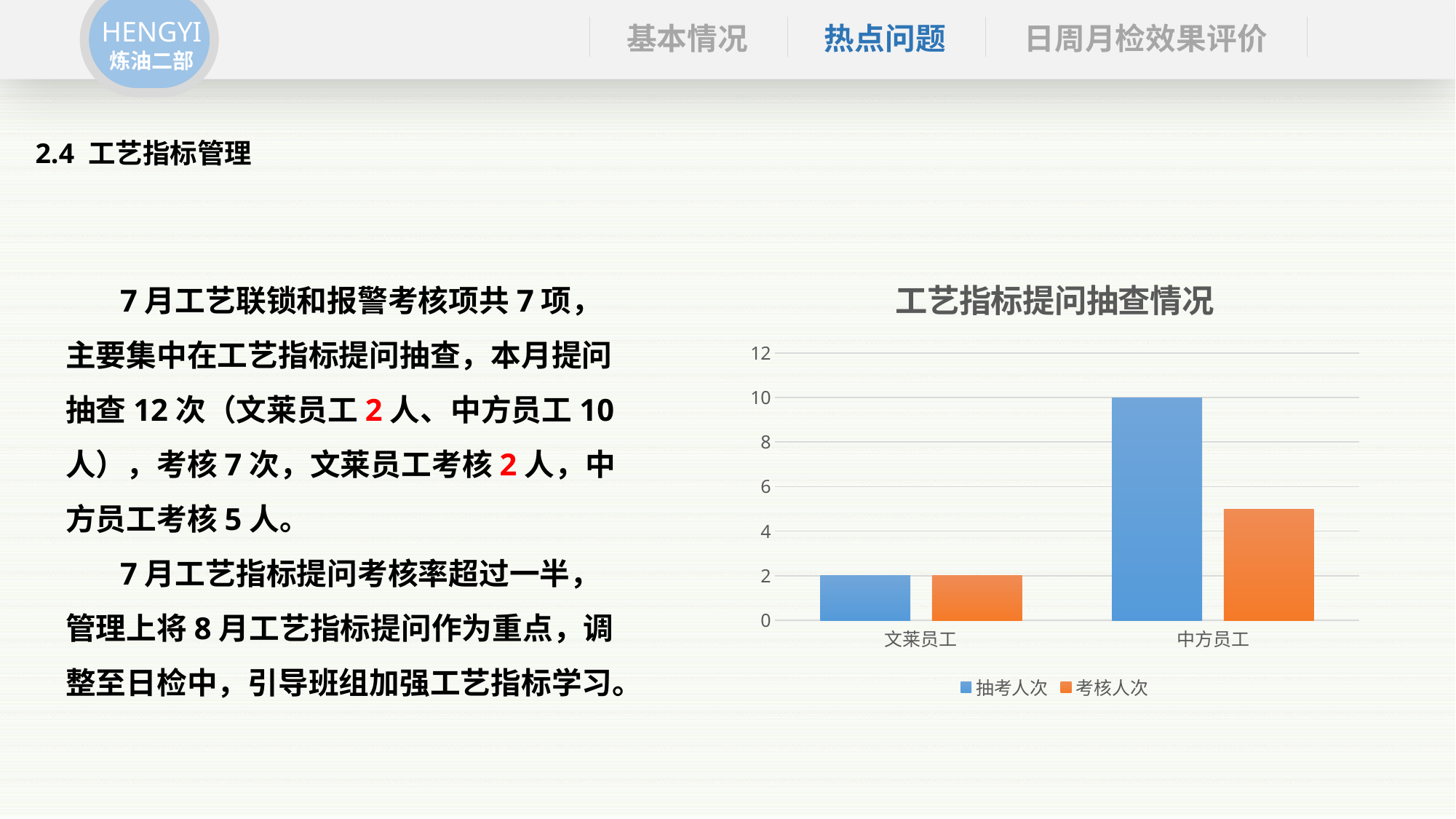
What is the 抽考人次 value for 文莱员工? 2 Is the 考核人次 value for 中方员工 greater or less than 6? less How many categories are shown on the x axis of the chart? 2 How many series does the chart legend list? 2 Which category has the highest 抽考人次 value? 中方员工 For 中方员工, which is larger: 抽考人次 or 考核人次? 抽考人次 What is the difference between the 抽考人次 values for 中方员工 and 文莱员工? 8 What is the 考核人次 value for 文莱员工? 2 What kind of chart is shown on the slide? bar chart What is the 抽考人次 value for 中方员工? 10 What is the title of the chart? 工艺指标提问抽查情况 Is the 考核人次 value for 中方员工 greater or less than 4? greater